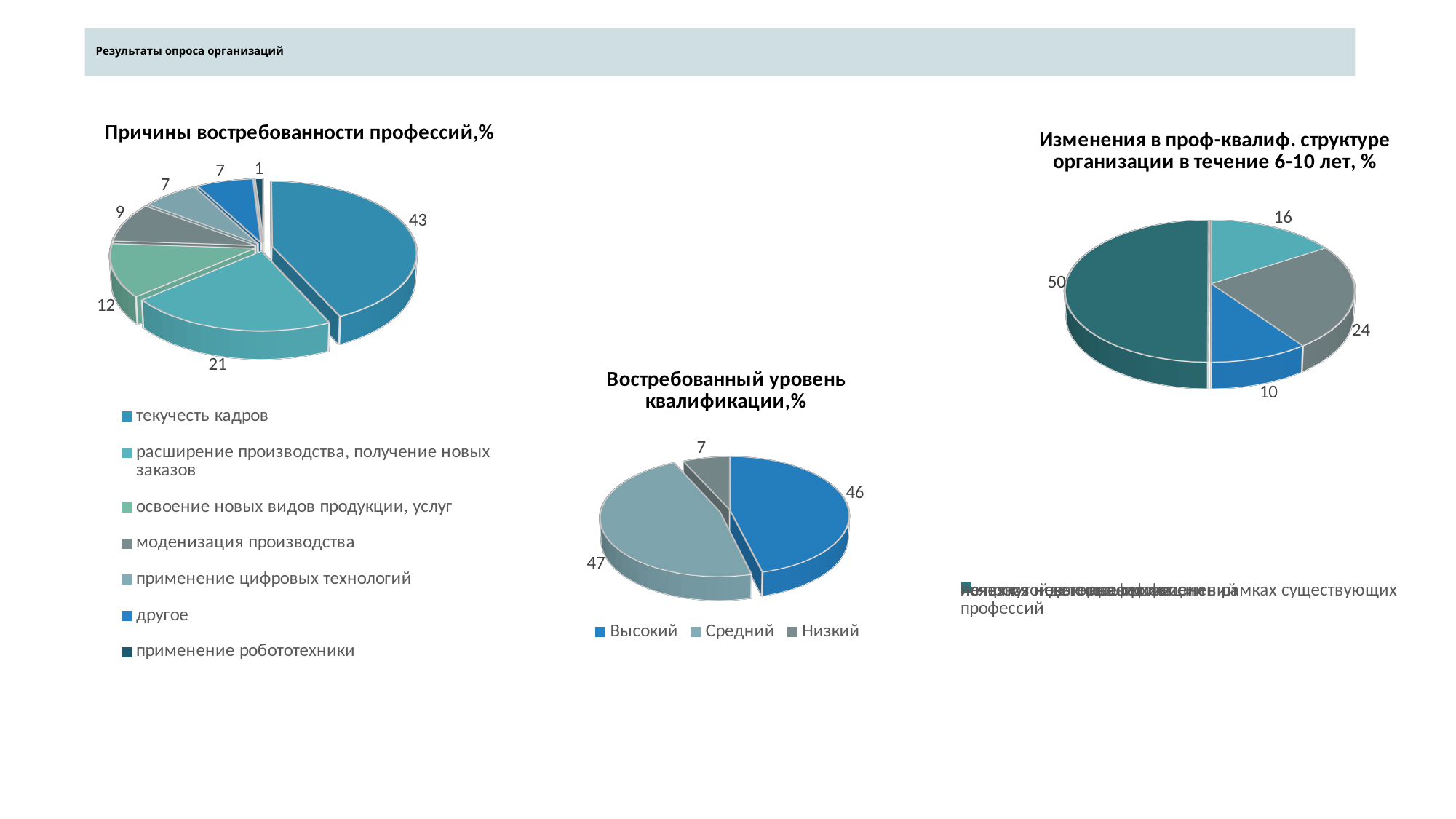
In the chart 'Востребованный уровень квалификации,%', how many categories does the legend list? 3 In the chart 'Причины востребованности профессий,%', which category has the smallest slice? применение робототехники In the chart 'Причины востребованности профессий,%', what is the difference between 'текучесть кадров' and 'освоение новых видов продукции, услуг'? 31 In the chart 'Причины востребованности профессий,%', which category has the largest slice? текучесть кадров In the chart 'Востребованный уровень квалификации,%', which category has the smallest slice? Низкий What type of chart is 'Изменения в проф-квалиф. структуре организации в течение 6-10 лет, %'? pie chart In the chart 'Причины востребованности профессий,%', what is the value for 'текучесть кадров'? 43 In the chart 'Причины востребованности профессий,%', what is the value for 'применение робототехники'? 1 In the chart 'Востребованный уровень квалификации,%', what is the value for 'Высокий'? 46 In the chart 'Причины востребованности профессий,%', how many categories does the legend list? 7 In the chart 'Причины востребованности профессий,%', what is the value for 'расширение производства, получение новых заказов'? 21 In the chart 'Изменения в проф-квалиф. структуре организации в течение 6-10 лет, %', what is the largest value shown on a slice? 50